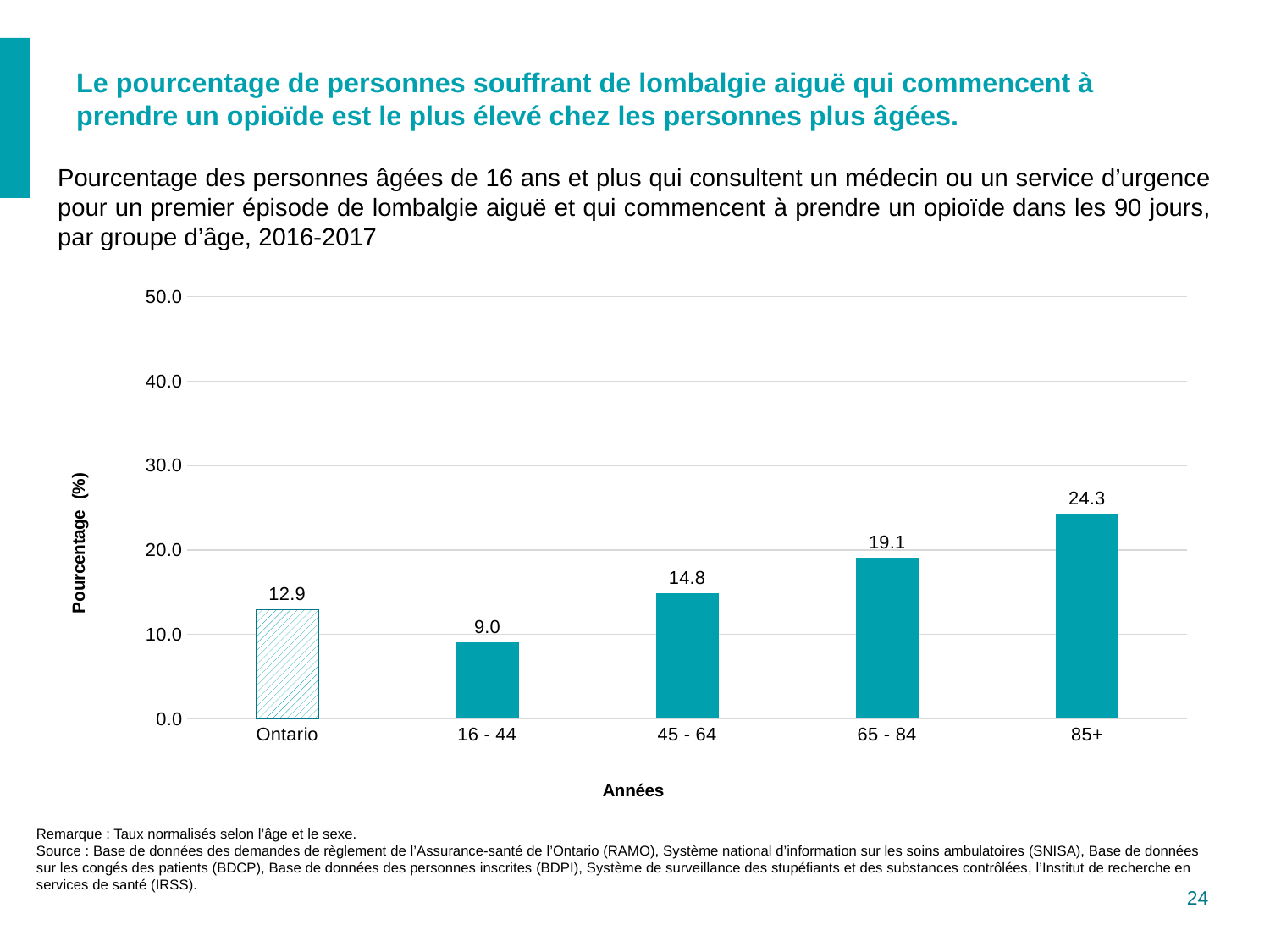
What is the value for the 85+ age group? 24.3 What is the value for Ontario? 12.9 What is the value for the 16 - 44 age group? 9.0 What kind of chart is shown on the slide? bar chart Which is larger, the value for 45 - 64 or the value for Ontario? 45 - 64 Which category has the lowest value? 16 - 44 What is the difference between the values for 85+ and 16 - 44? 15.3 How many categories are shown on the x axis? 5 Is the value for 65 - 84 greater or less than 20.0? less What is the value for the 65 - 84 age group? 19.1 Which category has the highest value? 85+ What is the label of the x axis? Années